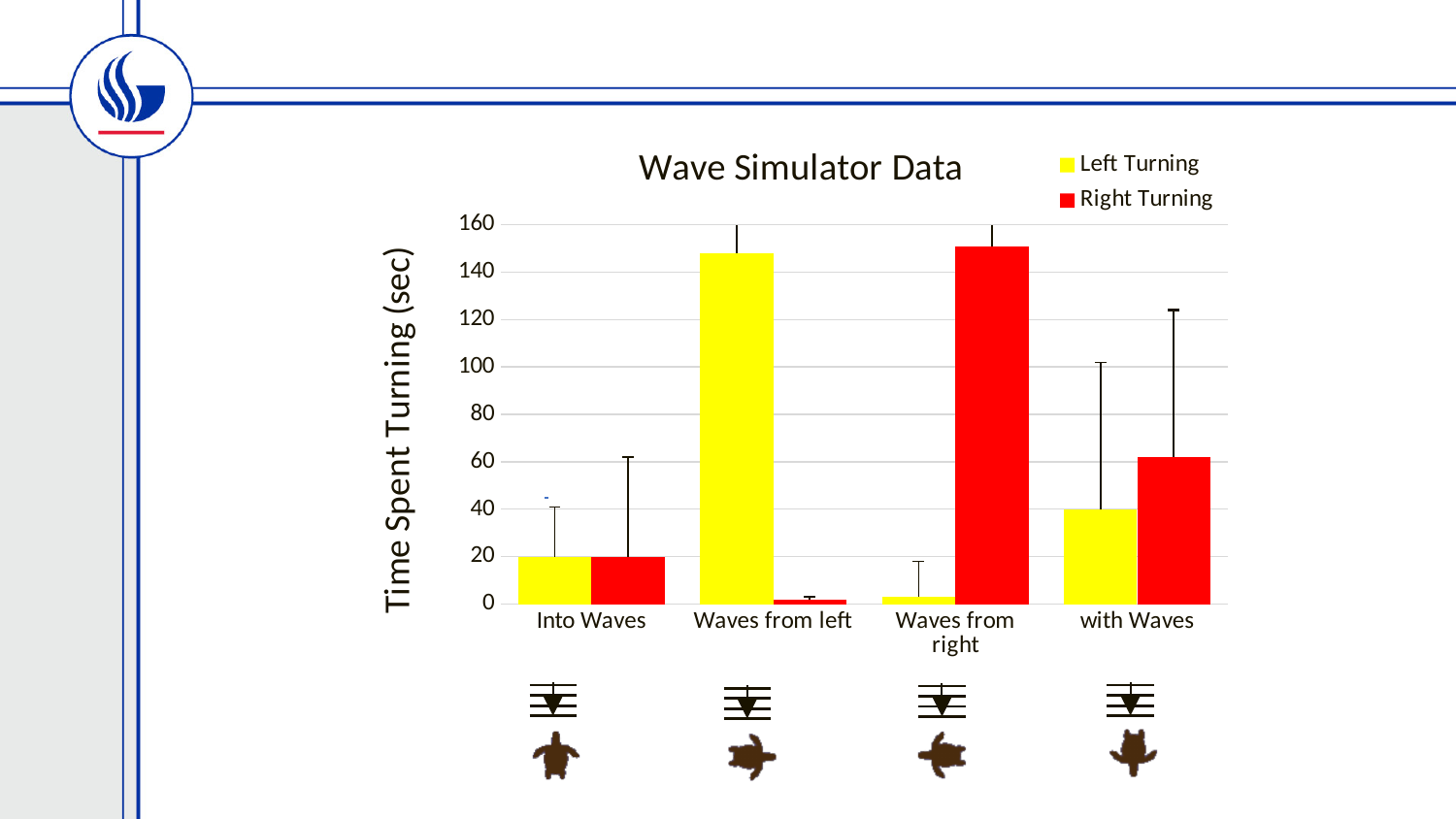
How many categories are shown on the x axis? 4 For the Right Turning series, which category has the highest value? Waves from right What is the label of the vertical axis? Time Spent Turning (sec) In the with Waves category, which series has the larger value, Left Turning or Right Turning? Right Turning What is the title of the chart? Wave Simulator Data For the Left Turning series, which category has the lowest value? Waves from right Is the Right Turning value for with Waves greater or less than 40? greater How many series does the legend list? 2 For the Right Turning series, which category has the lowest value? Waves from left What kind of chart is shown on the slide? bar chart Is the Left Turning value for Waves from left greater or less than 140? greater For the Left Turning series, which category has the highest value? Waves from left